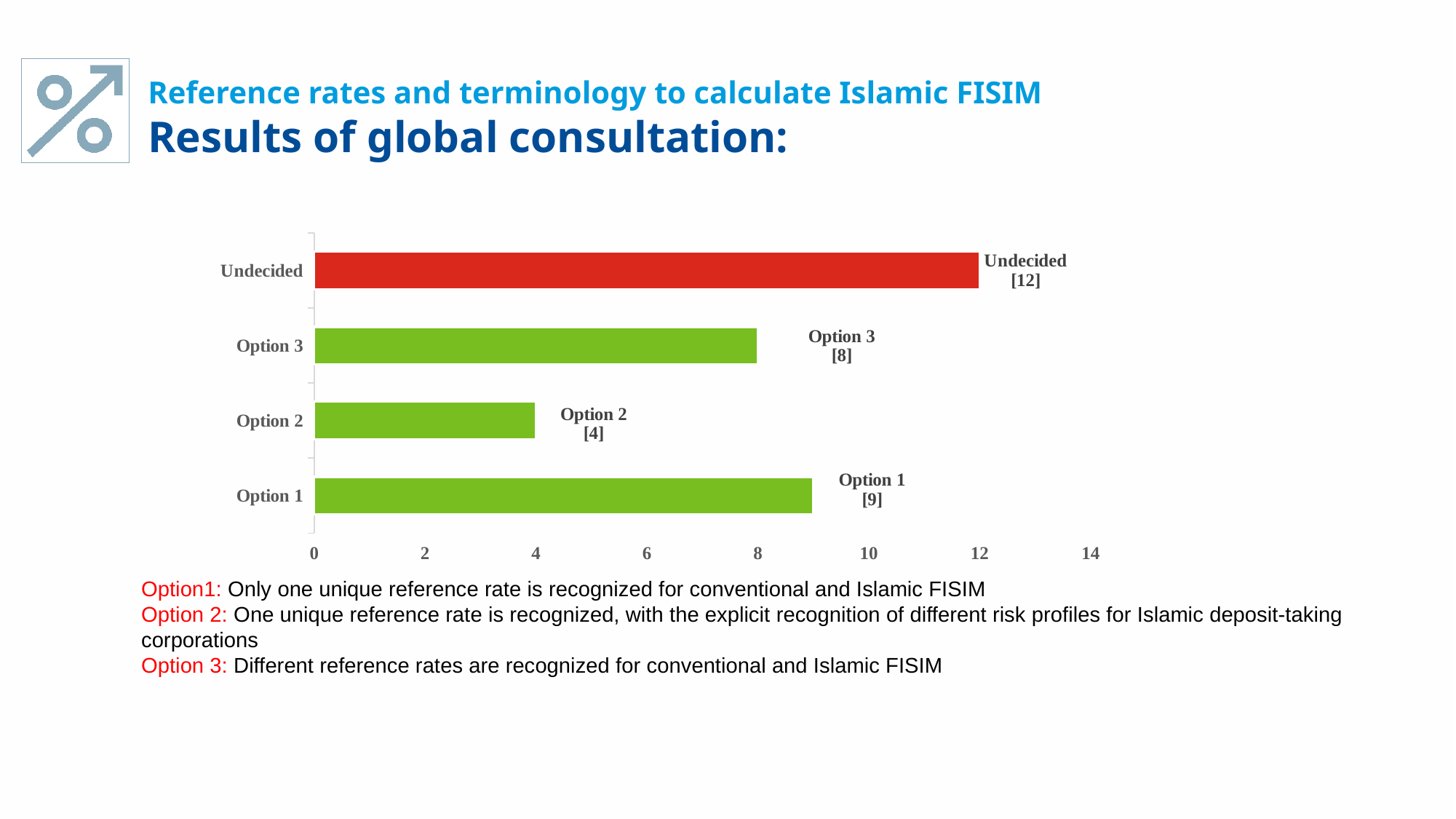
How many categories are shown in the chart? 4 Which is larger, the value for Option 1 or the value for Option 3? Option 1 What is the difference between the values for Undecided and Option 1? 3 Which category has the highest value? Undecided What is the value for Option 2? 4 What is the value for Option 1? 9 What kind of chart is shown on the slide? bar chart What is the value for Undecided? 12 Which category has the lowest value? Option 2 What is the difference between the values for Option 3 and Option 2? 4 What is the value for Option 3? 8 Is the value for Option 1 greater or less than 10? less